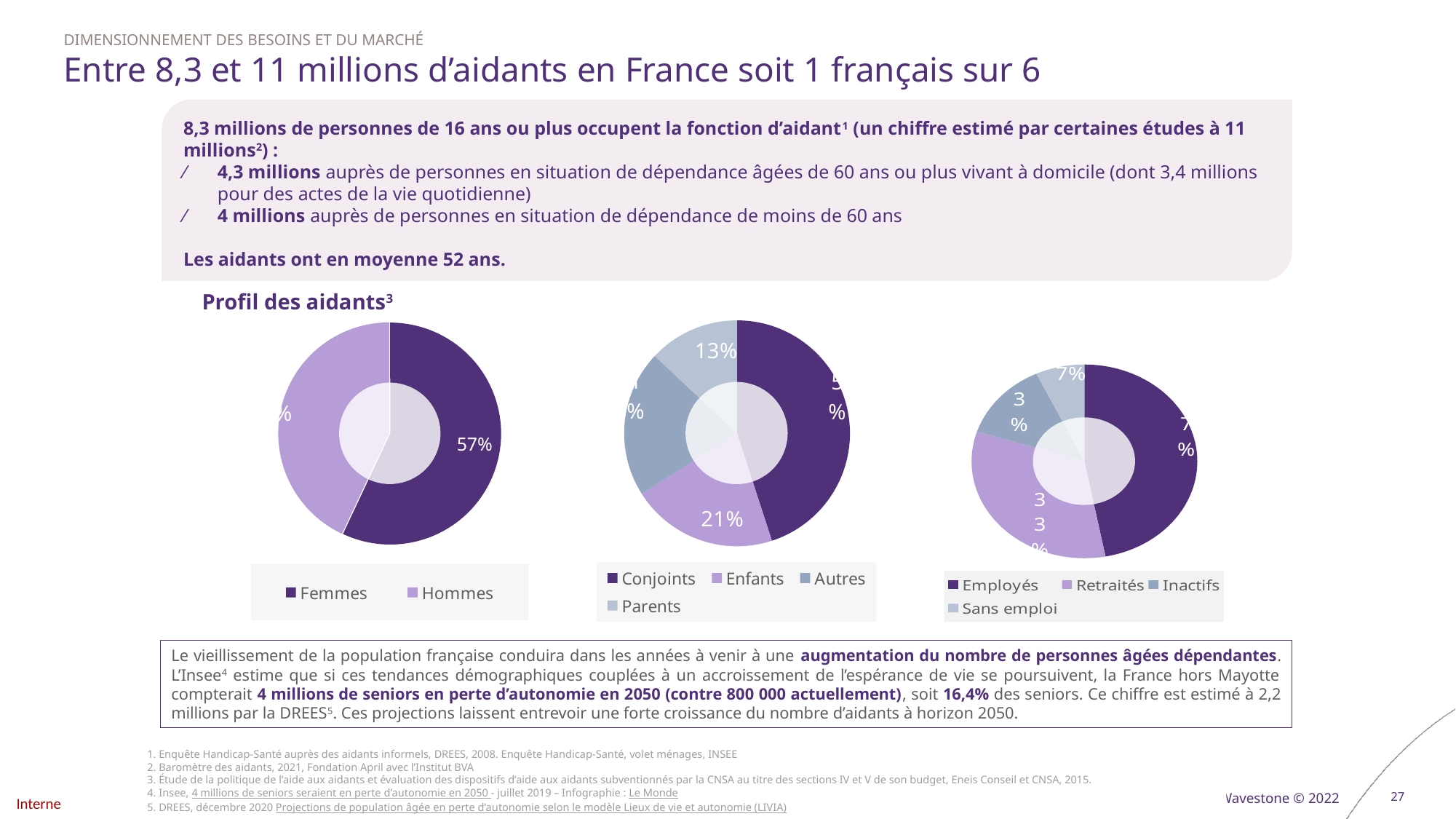
How many categories does the legend of the middle chart list? 4 In the middle donut chart, what is the value for Parents? 13% In the middle donut chart, which category has the largest share? Conjoints In the middle donut chart, what is the difference between the Enfants and Parents shares? 8 percentage points In the right donut chart (Employés/Retraités/Inactifs/Sans emploi), what is the value for Sans emploi? 7% In the left donut chart, which is larger, Femmes or Hommes? Femmes In the middle donut chart (Conjoints/Enfants/Autres/Parents), what is the value for Enfants? 21% What kind of chart is the left chart showing Femmes and Hommes? Donut (pie) chart In the right donut chart, which category has the largest share? Employés In the left donut chart (Femmes/Hommes), what is the value for Femmes? 57% In the middle donut chart, which is larger, Enfants or Parents? Enfants How many categories does the legend of the left chart list? 2